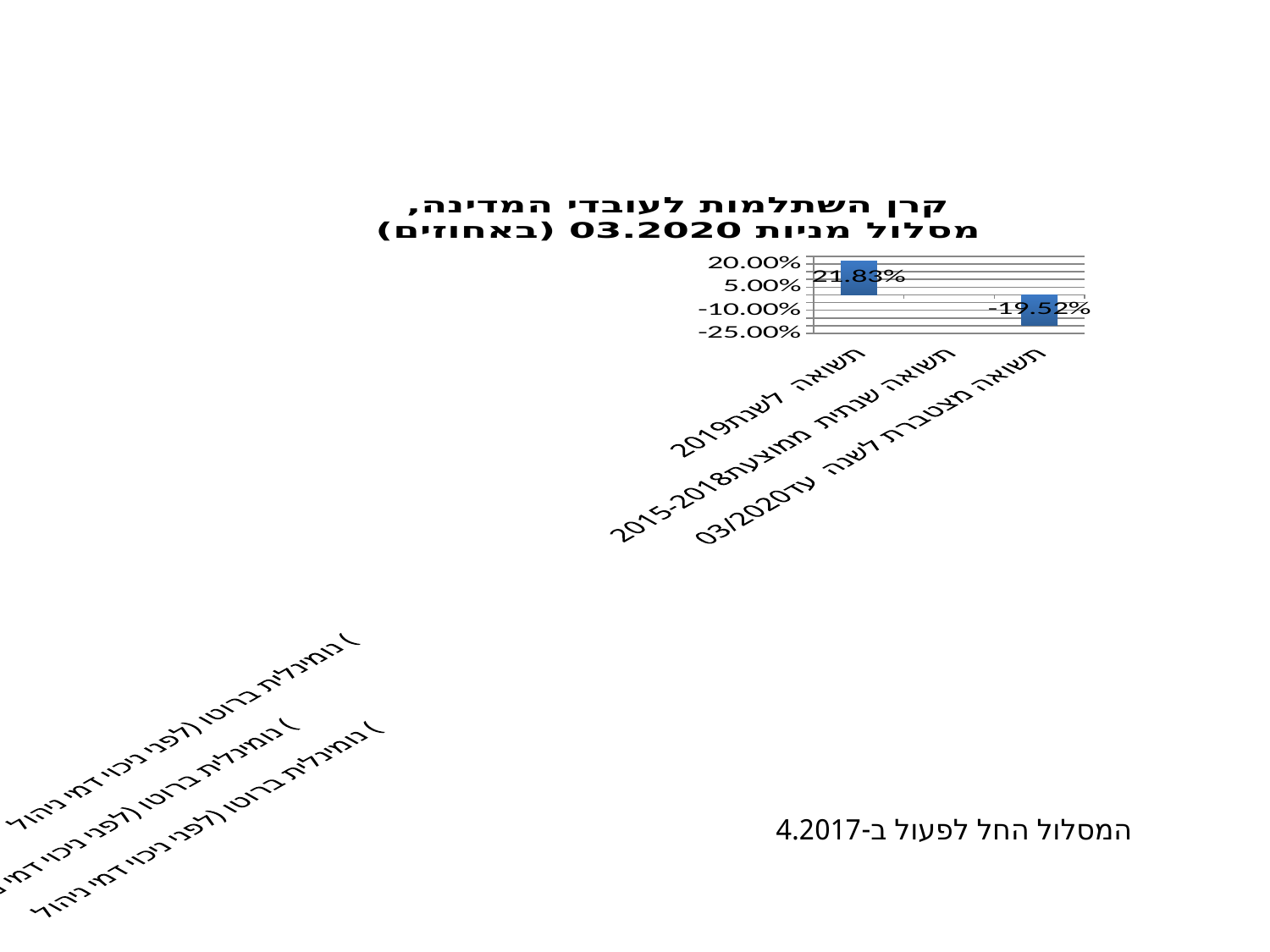
Which is larger: the value for תשואה לשנת 2019 or the value for תשואה מצטברת לשנה עד 03/2020? תשואה לשנת 2019 What is the value shown for תשואה לשנת 2019? 21.83% Is the value for תשואה מצטברת לשנה עד 03/2020 greater or less than -10.00%? less Which category has the highest value in the chart? תשואה לשנת 2019 Which category has the lowest value in the chart? תשואה מצטברת לשנה עד 03/2020 What kind of chart is shown on the slide? bar chart Is the value for תשואה לשנת 2019 greater or less than 5.00%? greater What is the value shown for תשואה מצטברת לשנה עד 03/2020? -19.52% What is the difference between the value for תשואה לשנת 2019 and the value for תשואה מצטברת לשנה עד 03/2020? 41.35 percentage points Which category on the x axis has no bar plotted? תשואה שנתית ממוצעת 2015-2018 What is the title of the chart? קרן השתלמות לעובדי המדינה, מסלול מניות 03.2020 (באחוזים) How many categories are labelled on the x axis of the chart? 3